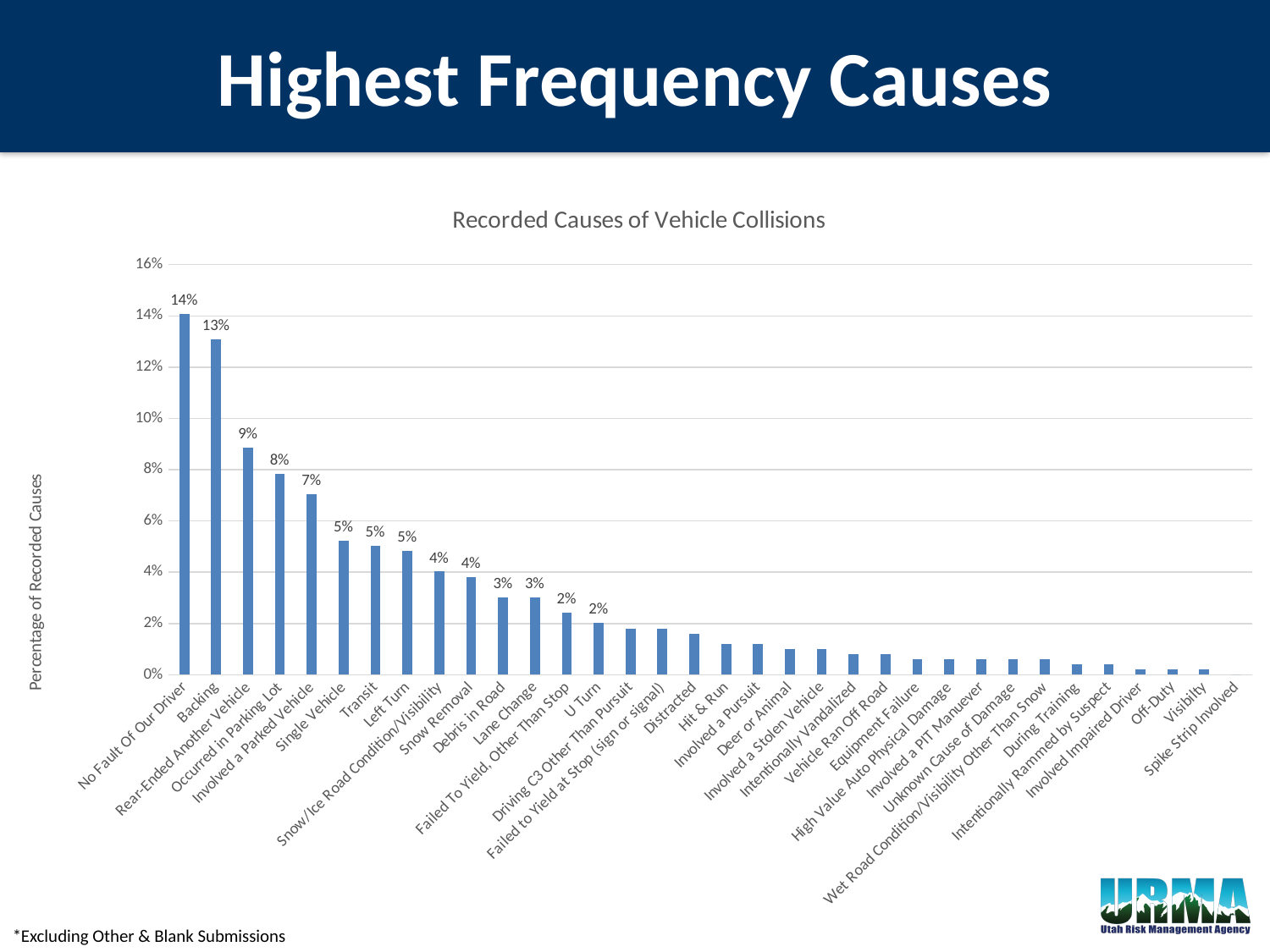
Do the bar values rise or fall moving from left to right along the x axis? Fall Is the value for 'Distracted' greater or less than 2%? less Which is larger, the value for 'Rear-Ended Another Vehicle' or the value for 'Involved a Parked Vehicle'? Rear-Ended Another Vehicle What is the difference between the values for 'No Fault Of Our Driver' and 'Backing'? 1% What type of chart is shown on the slide? Bar chart What percentage is shown for 'Occurred in Parking Lot'? 8% What is the label on the vertical axis of the chart? Percentage of Recorded Causes What is the value for 'Involved a Parked Vehicle'? 7% What percentage of recorded causes is attributed to 'No Fault Of Our Driver'? 14% What is the value shown for 'Backing'? 13% What is the title of the chart? Recorded Causes of Vehicle Collisions Which cause has the highest percentage of recorded causes? No Fault Of Our Driver